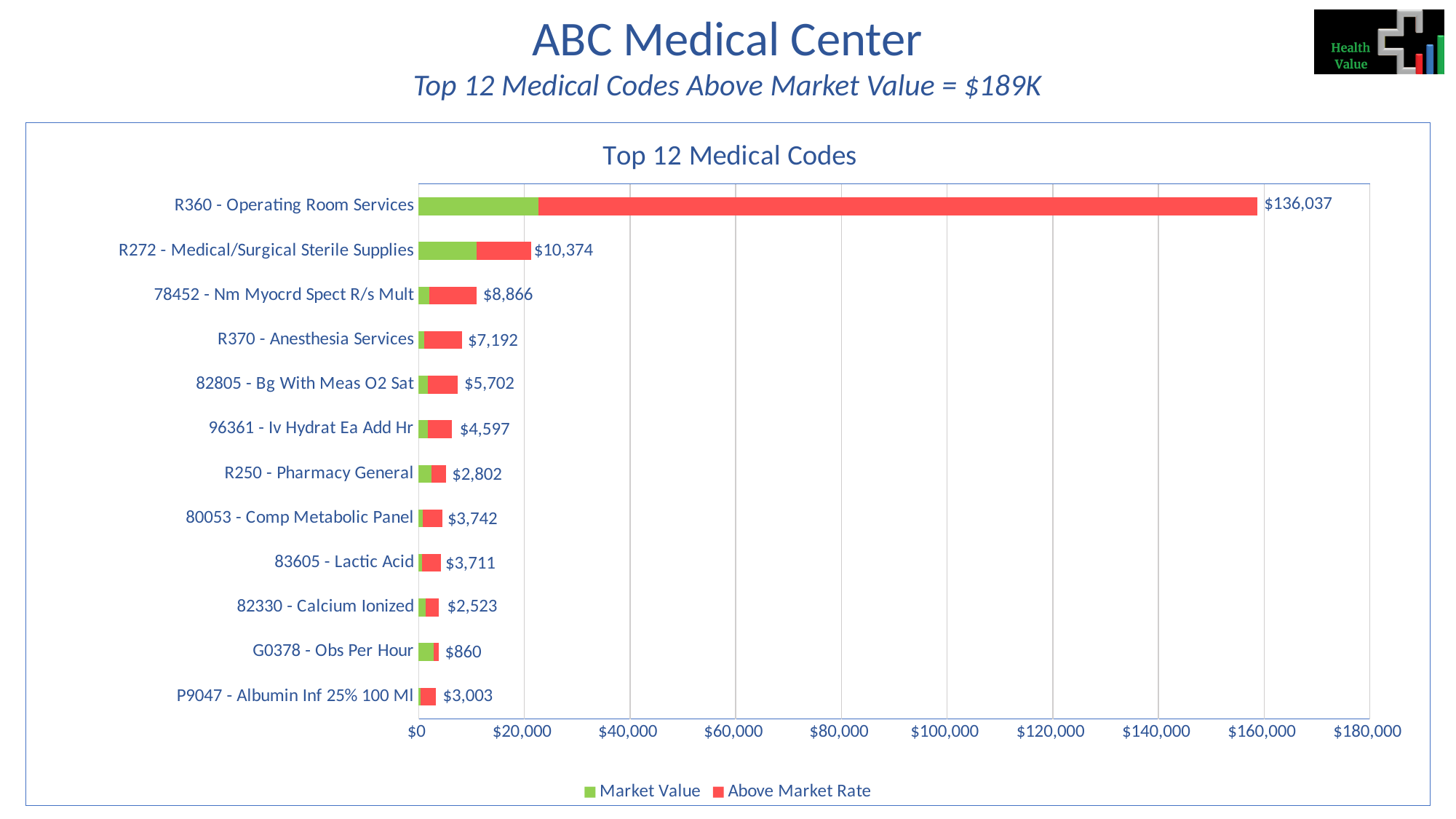
What is the Above Market Rate value labelled for R272 - Medical/Surgical Sterile Supplies? $10,374 What kind of chart is shown on the slide? Stacked bar chart How many medical codes are plotted in the chart? 12 What is the Above Market Rate value shown for R360 - Operating Room Services? $136,037 What is the Above Market Rate value labelled for G0378 - Obs Per Hour? $860 Which medical code has the lowest labelled Above Market Rate value? G0378 - Obs Per Hour What are the two series named in the legend? Market Value and Above Market Rate Which medical code has the highest labelled Above Market Rate value? R360 - Operating Room Services Is the total bar length for R360 - Operating Room Services greater or less than $140,000? greater How many series does the legend list? 2 What is the difference between the labelled values for R272 - Medical/Surgical Sterile Supplies and 78452 - Nm Myocrd Spect R/s Mult? $1,508 Which has a larger labelled value: R250 - Pharmacy General or 80053 - Comp Metabolic Panel? 80053 - Comp Metabolic Panel